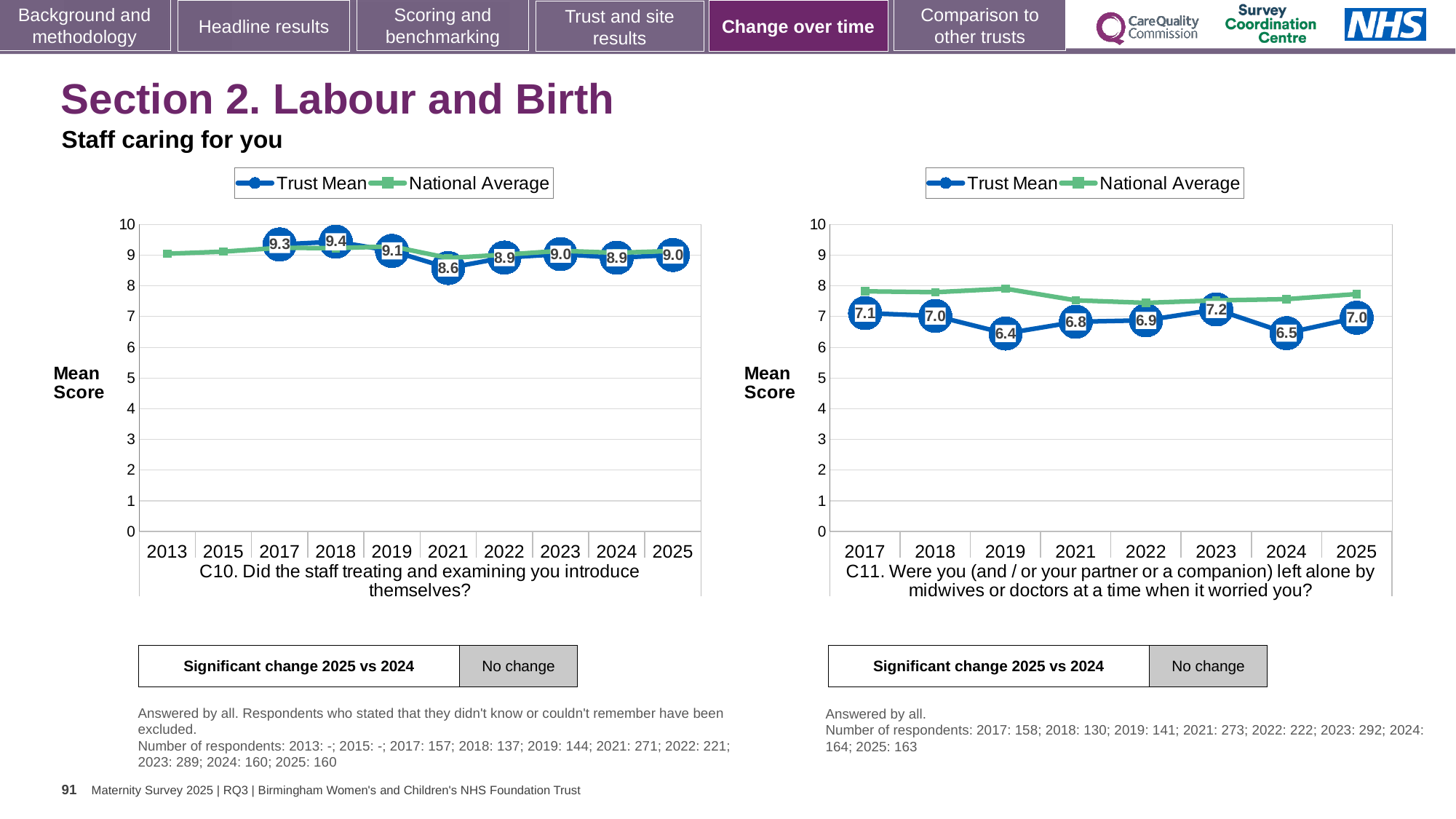
In the C11 chart on the right, which year has the lowest Trust Mean? 2019 In the C10 chart on the left, how many series does the legend list? 2 In the C11 chart on the right, is the Trust Mean for 2024 or for 2025 larger? 2025 What kind of chart is the C11 chart on the right? Line chart In the C11 chart on the right, is the National Average for 2019 greater or less than 7? greater In the C11 chart on the right, which year has the highest Trust Mean? 2023 In the C10 chart on the left, which year has the highest Trust Mean? 2018 In the C11 chart on the right, what is the Trust Mean for 2019? 6.4 In the C10 chart on the left, what is the Trust Mean for 2021? 8.6 In the C10 chart on the left, which year has the lowest Trust Mean? 2021 In the C10 chart on the left, how many years are shown on the x axis? 10 In the C10 chart on the left, what is the difference between the Trust Mean in 2018 and in 2021? 0.8